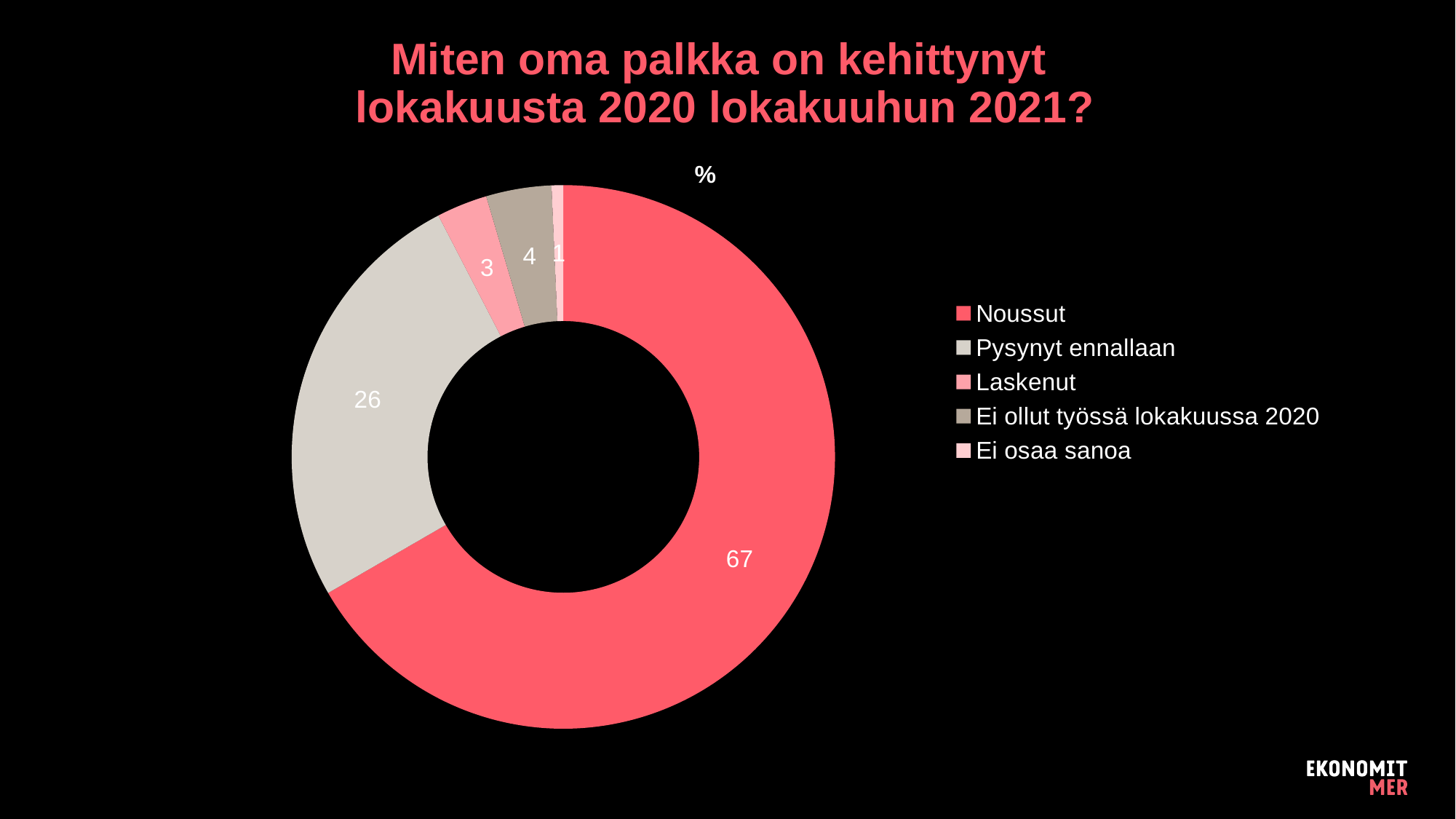
How many categories does the legend list? 5 What is the value for Laskenut? 3 Which category has the largest share of the chart? Noussut What is the value for Ei osaa sanoa? 1 What kind of chart is shown on the slide? Doughnut (pie) chart Which category has the smallest share of the chart? Ei osaa sanoa What is the value for Noussut? 67 What is the difference between the values for Noussut and Pysynyt ennallaan? 41 What is the value for Ei ollut työssä lokakuussa 2020? 4 What is the value for Pysynyt ennallaan? 26 Which is larger, the value for Laskenut or the value for Ei ollut työssä lokakuussa 2020? Ei ollut työssä lokakuussa 2020 What is the title of the slide? Miten oma palkka on kehittynyt lokakuusta 2020 lokakuuhun 2021?